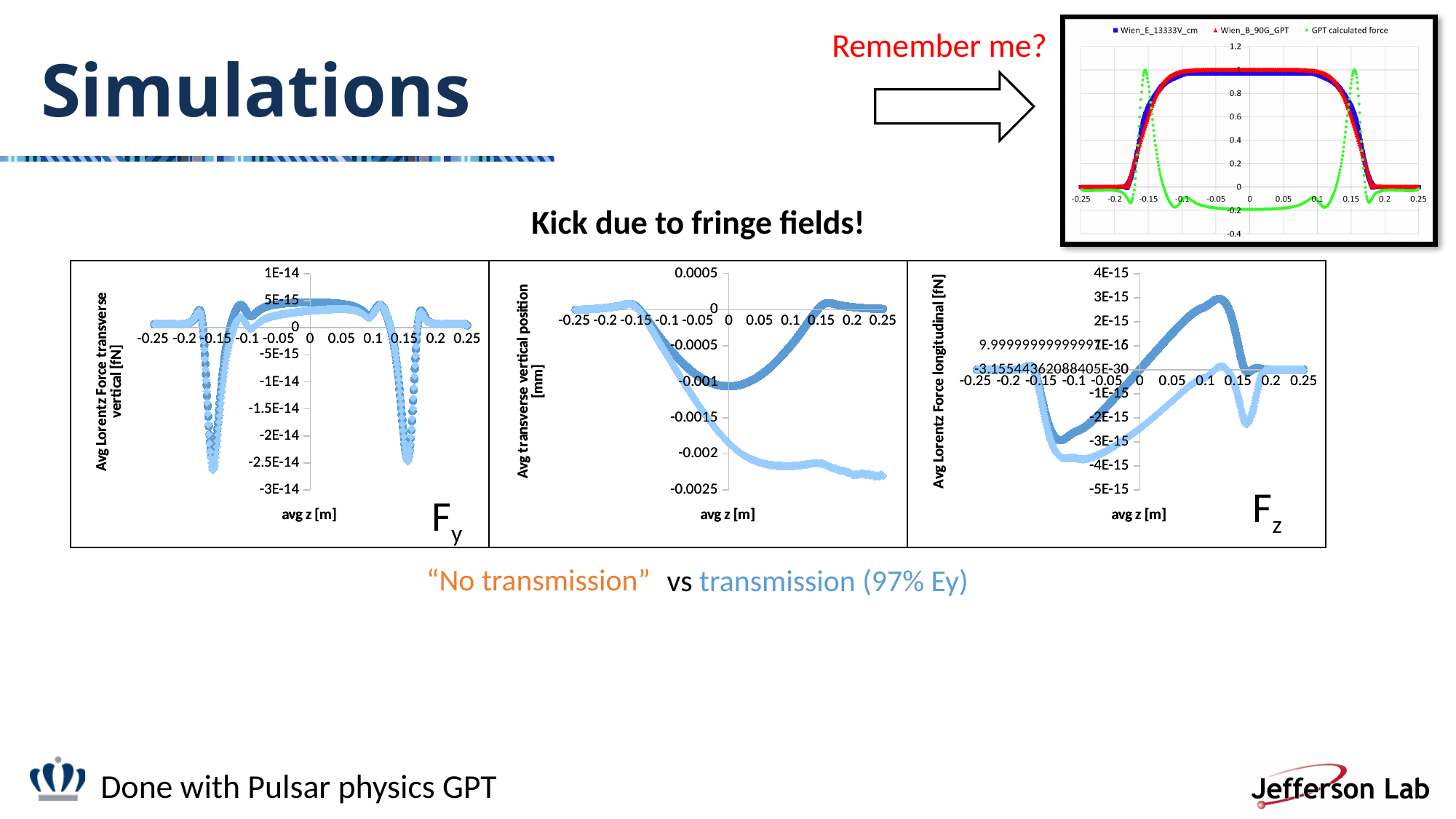
In the left chart (Fy), is the value at the dip near avg z = -0.15 greater or less than -2E-14? less How many series does the legend of the top-right chart list? 3 In the right chart (Fz), is the peak value of the dark blue series near avg z = 0.1 greater or less than 2E-15? greater What is the highest tick value on the vertical axis of the top-right chart? 1.2 What is the x-axis label of the left chart (Fy) in the bottom row? avg z [m] What is the name of the third series in the legend of the top-right chart? GPT calculated force In the right chart (Fz), is the minimum of the light blue series near avg z = -0.15 greater or less than -3E-15? less What kind of chart is the right chart (Fz) in the bottom row? scatter chart In the middle chart, at avg z = 0.25, which series has the higher value, the dark blue or the light blue? dark blue